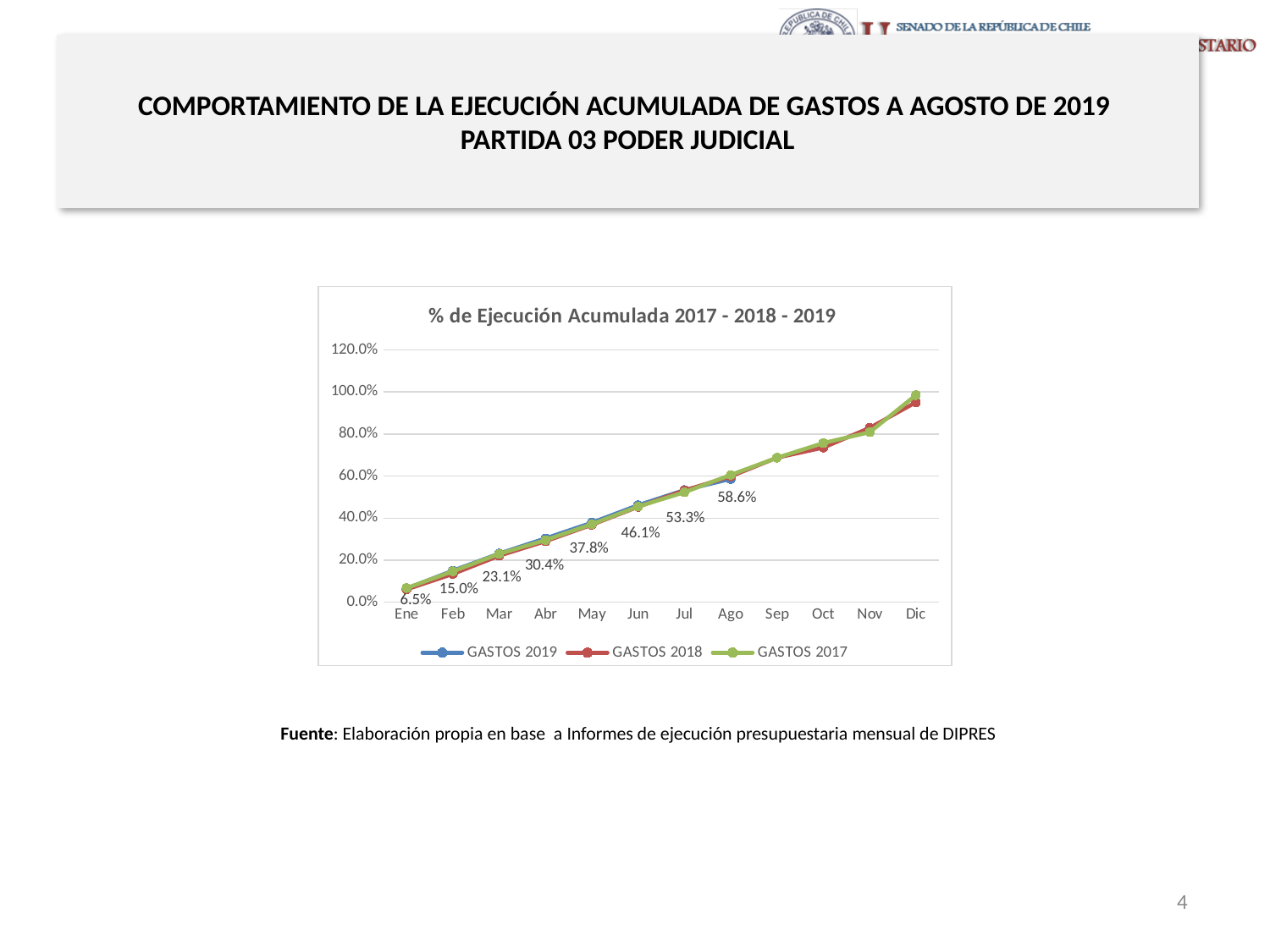
How many months are shown on the x axis of the chart? 12 What is the title of the chart? % de Ejecución Acumulada 2017 - 2018 - 2019 What is the labelled value for GASTOS 2019 in Abr? 30.4% What type of chart is shown on the slide? line chart What is the labelled value for GASTOS 2019 in Jun? 46.1% How many series does the chart legend list? 3 Do the GASTOS 2019 values rise or fall from Ene to Ago? rise What is the labelled value for GASTOS 2019 in Ago? 58.6% What is the difference between the GASTOS 2019 values for Ago and Jul? 5.3% Is the value for GASTOS 2018 in Dic greater or less than 80.0%? greater Is the value for GASTOS 2017 in Sep greater or less than 80.0%? less What is the labelled value for GASTOS 2019 in Ene? 6.5%